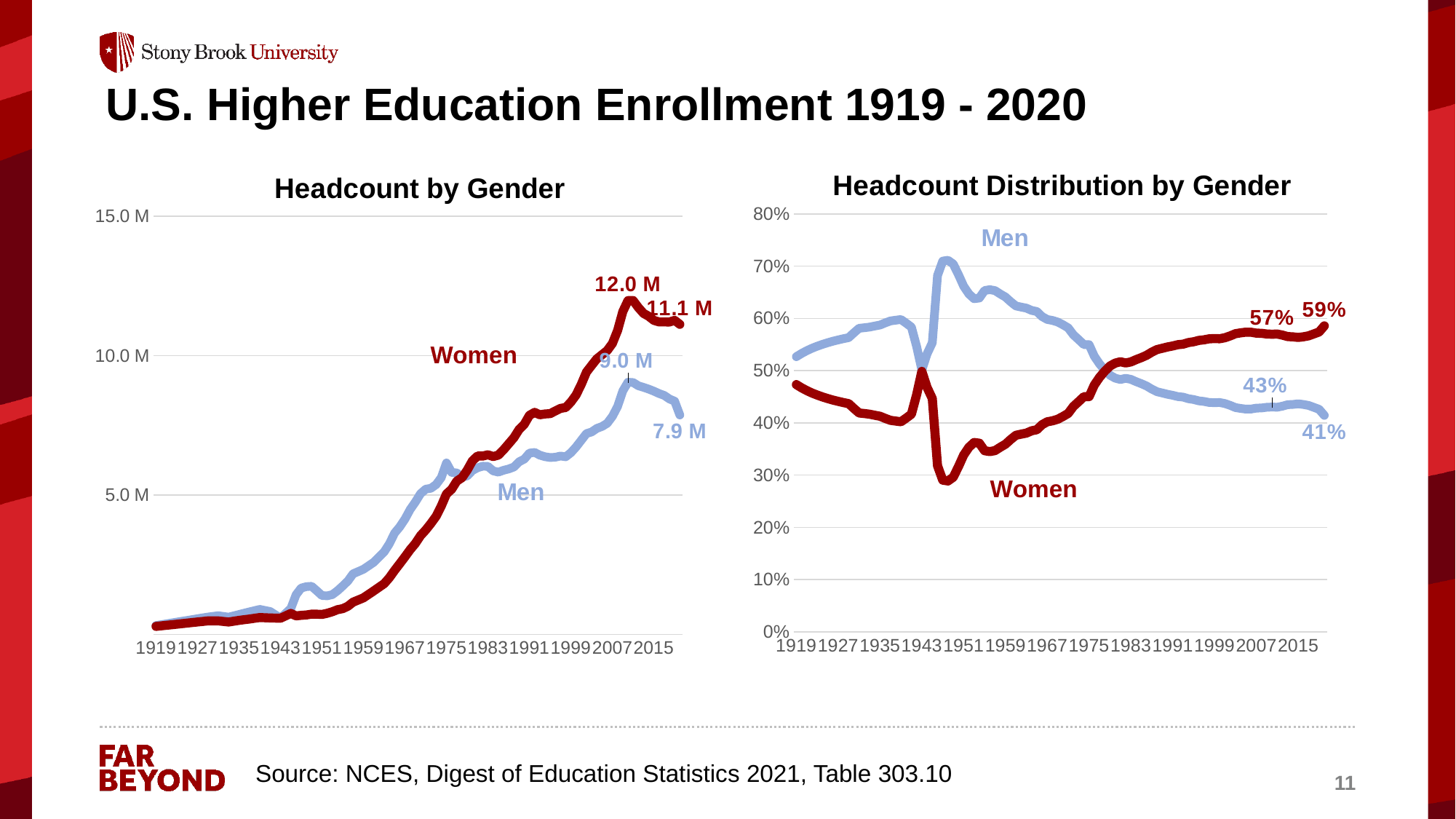
In the 'Headcount Distribution by Gender' chart, what is the final labeled share for Women? 59% In the 'Headcount Distribution by Gender' chart, does the Women series rise or fall from 1975 to 2015? Rise In the 'Headcount by Gender' chart, which series has the higher final labeled value, Women or Men? Women In the 'Headcount by Gender' chart, what is the final labeled value for Men? 7.9 M In the 'Headcount by Gender' chart, what is the difference between the final labeled values for Women (11.1 M) and Men (7.9 M)? 3.2 M In the 'Headcount by Gender' chart, what is the peak labeled value for Women? 12.0 M What type of chart is 'Headcount by Gender'? Line chart In the 'Headcount Distribution by Gender' chart, what is the final labeled share for Men? 41% In the 'Headcount Distribution by Gender' chart, what is the difference between the final labeled shares for Women (59%) and Men (41%)? 18% In the 'Headcount Distribution by Gender' chart, is the Men share in 1951 greater or less than 60%? greater In the 'Headcount by Gender' chart, what is the peak labeled value for Men? 9.0 M In the 'Headcount by Gender' chart, what is the final labeled value for Women? 11.1 M